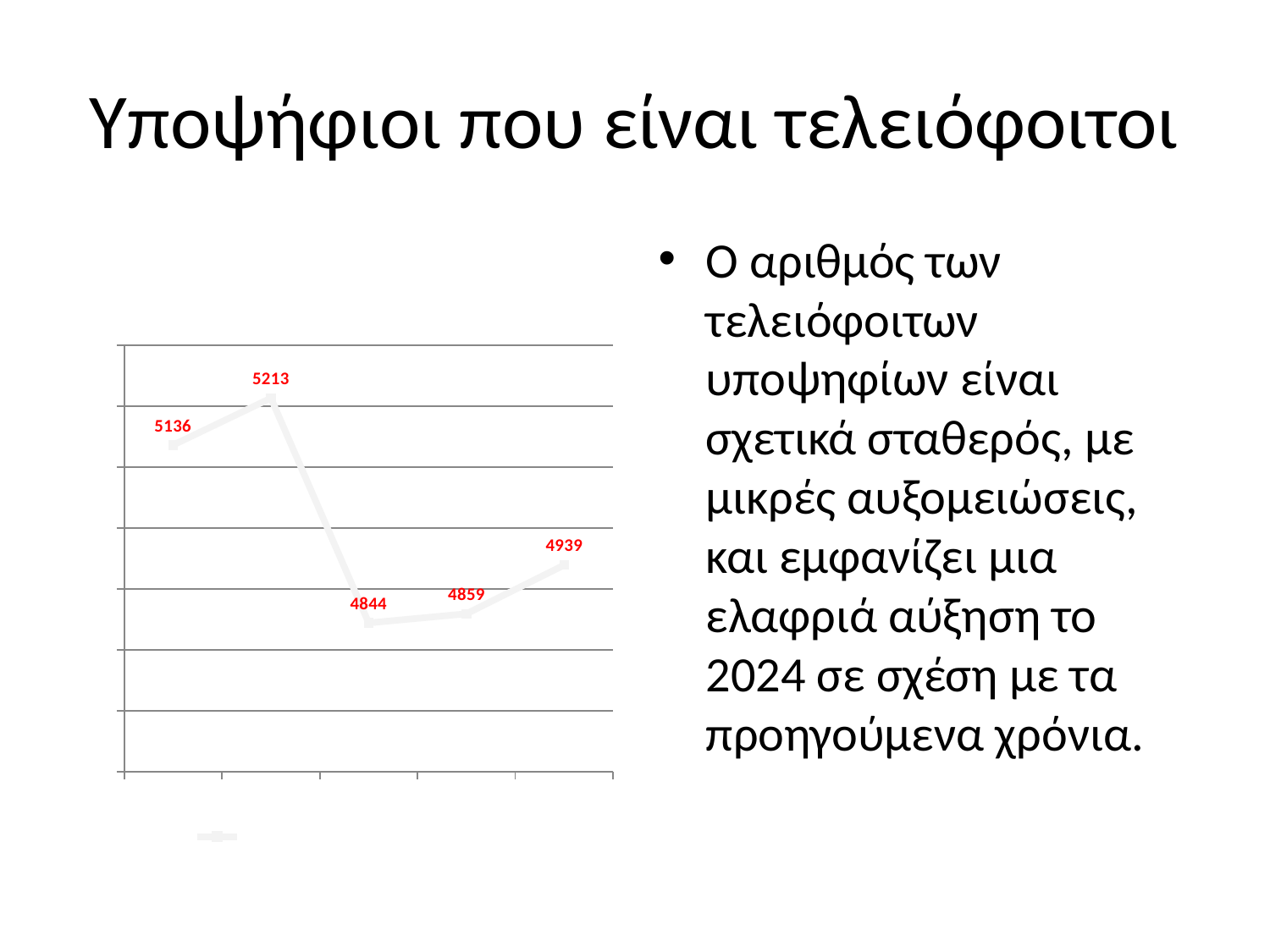
What is the lowest value shown on the line chart? 4844 How many data points are plotted on the line chart? 5 What is the highest value shown on the line chart? 5213 Which is larger on the line chart: the first data point or the last data point? the first data point (5136) Do the values on the line chart rise or fall from the second data point to the third data point? fall What is the value of the first data point on the line chart? 5136 What is the difference between the highest value (5213) and the lowest value (4844) on the line chart? 369 What is the difference between the fourth data point (4859) and the third data point (4844)? 15 What is the value of the second data point on the line chart? 5213 What is the value of the third data point on the line chart? 4844 What is the value of the last data point on the line chart? 4939 What type of chart is shown on the slide? line chart